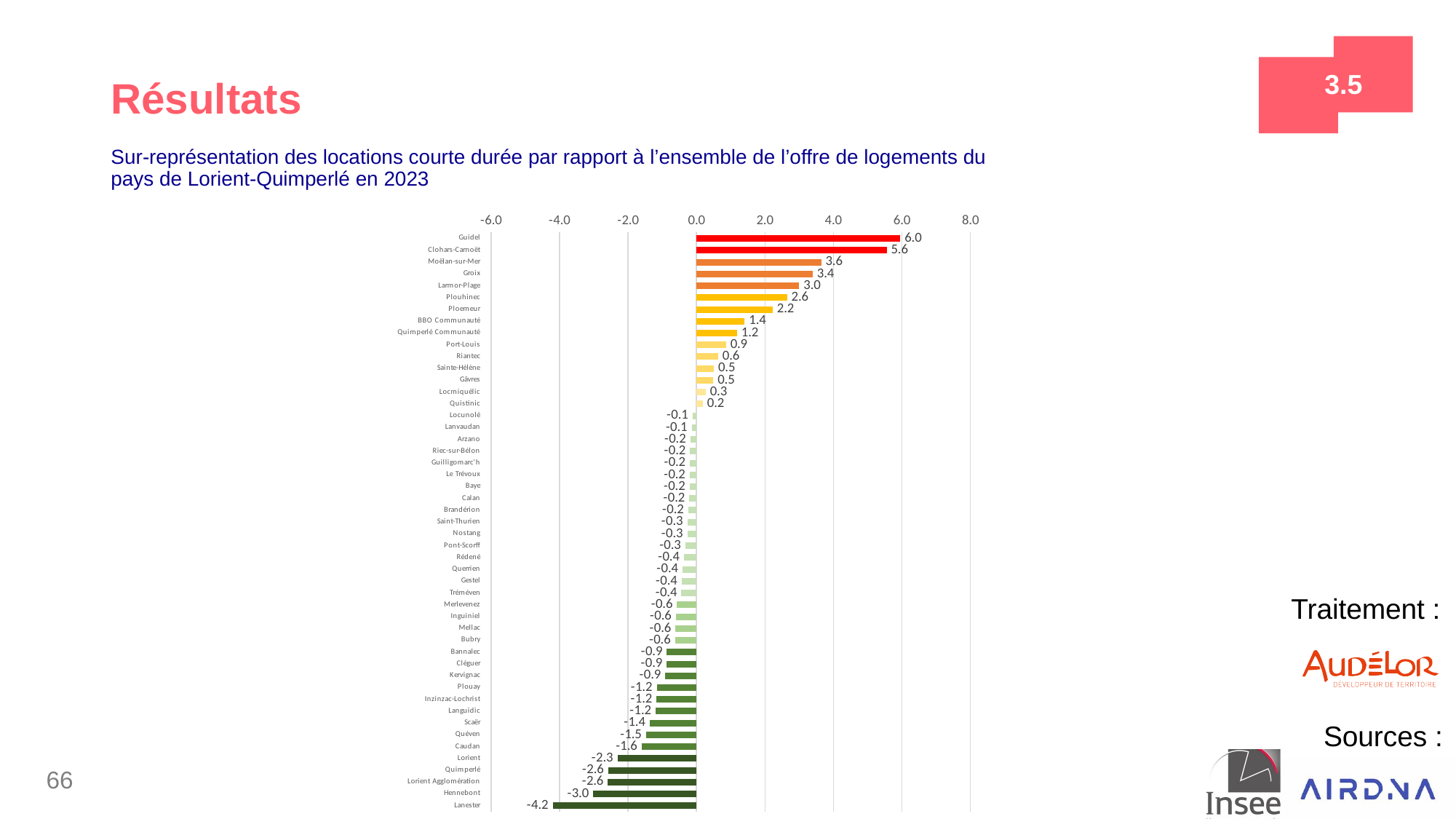
What is the value for Groix? 3.4 Which has a larger value, Moëlan-sur-Mer or Groix? Moëlan-sur-Mer What is the value for Hennebont? -3.0 What is the difference between the values for Guidel and Clohars-Carnoët? 0.4 Which category has the lowest value? Lanester What year does the chart's title refer to? 2023 What is the value for Lanester? -4.2 What is the value for Guidel? 6.0 Which category has the highest value? Guidel Is the value for Larmor-Plage greater or less than 2.0? greater Is the value for Lorient greater or less than -2.0? less What kind of chart is shown on the slide? bar chart